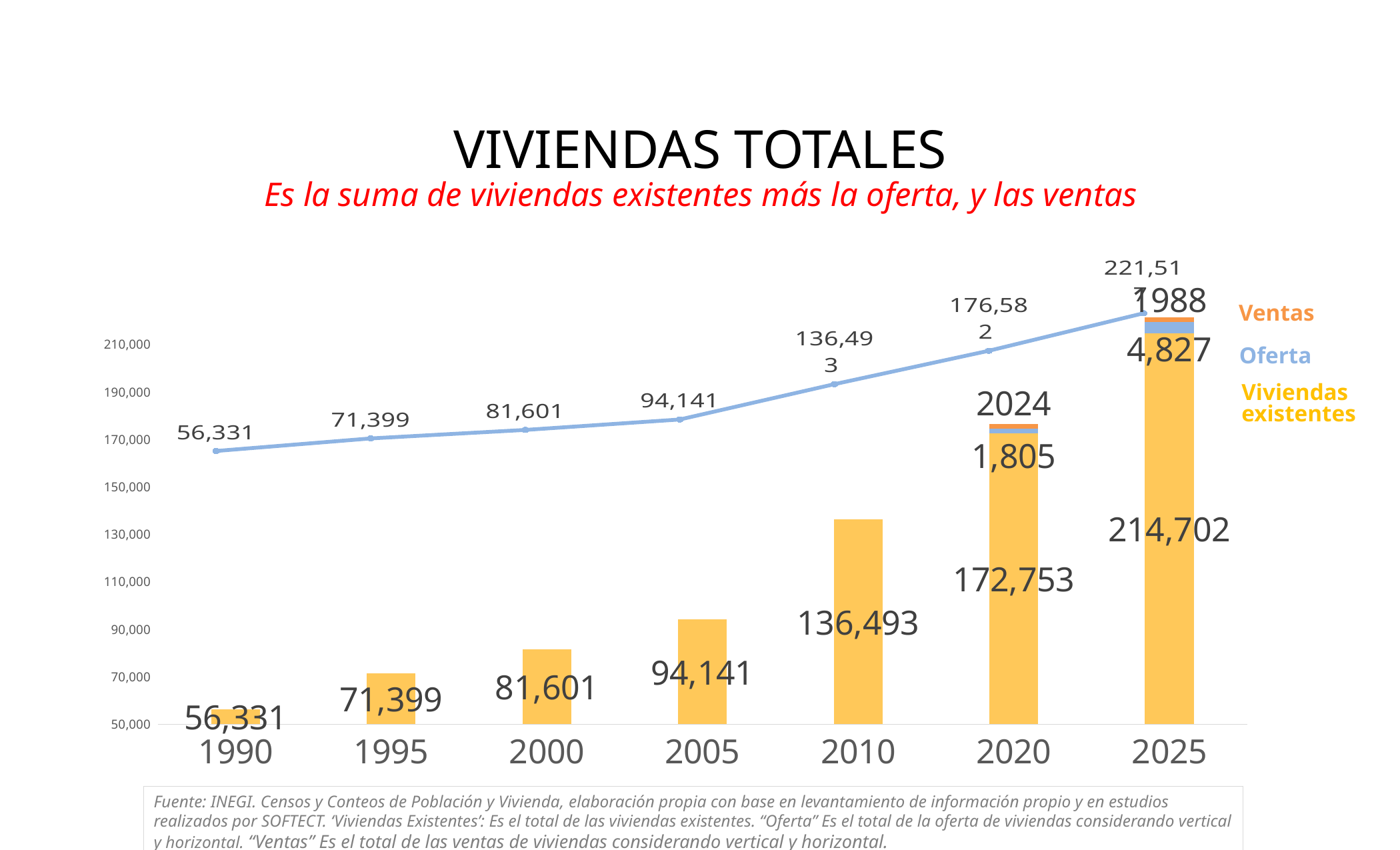
How many series does the legend list? 3 What is the total of the stacked bar for 2020? 176,582 What is the Ventas value for 2020? 2024 Do the Viviendas existentes values rise or fall from 1990 to 2025? Rise What kind of chart is this? Stacked bar chart combined with a line chart What is the difference between the Viviendas existentes values for 2000 and 1995? 10,202 How many years are shown on the x axis? 7 Which year has the highest value for Viviendas existentes? 2025 Which year has the lowest value for Viviendas existentes? 1990 Which year has the larger Oferta value, 2020 or 2025? 2025 What is the value of Viviendas existentes for 2010? 136,493 What is the Oferta value for 2025? 4,827